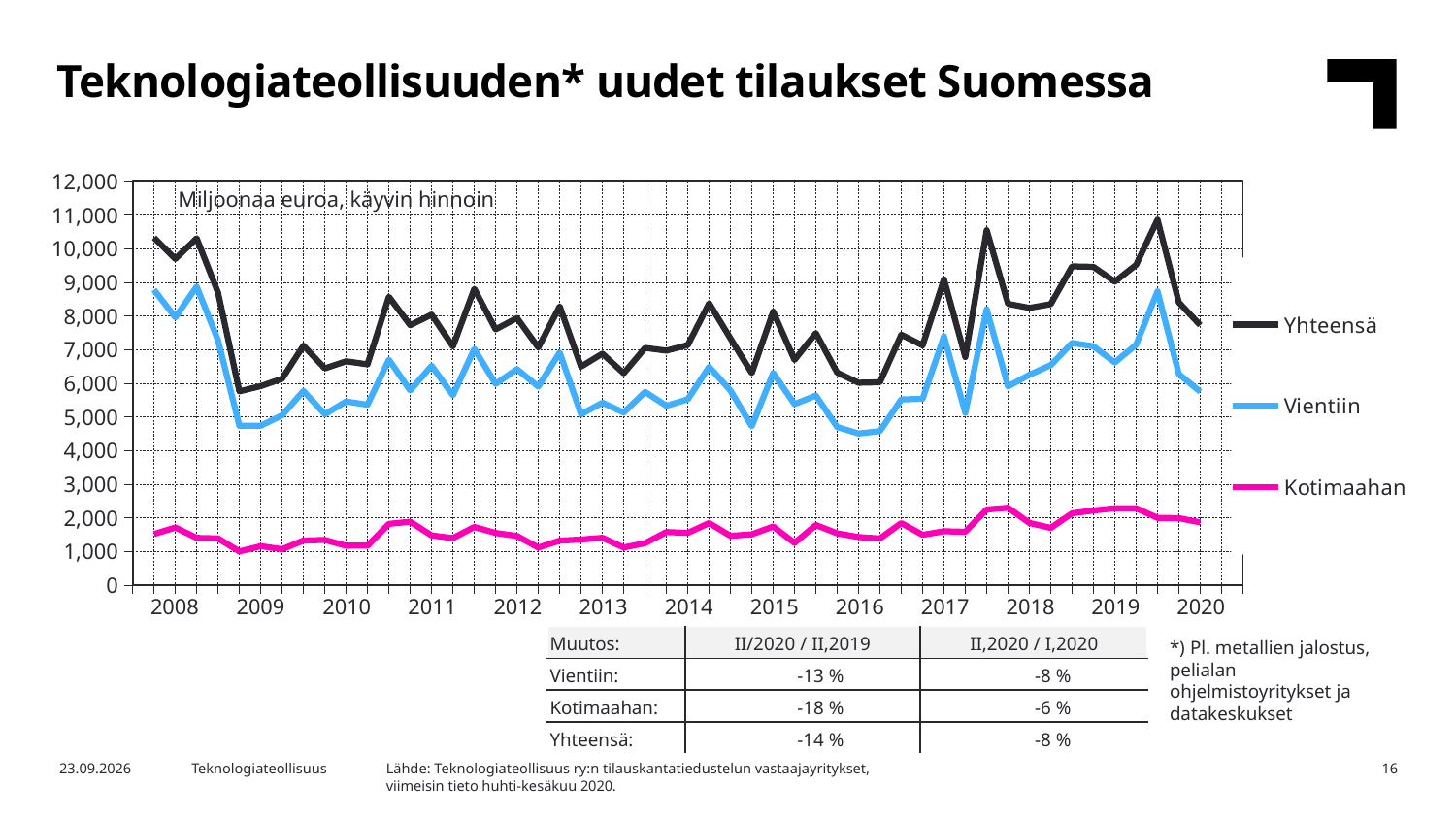
Which series is plotted with the pink line? Kotimaahan Is the first plotted value for Yhteensä in 2008 greater or less than 9,000? greater Do the Yhteensä values rise or fall from the 2019 peak to the end of 2020? fall What kind of chart is shown on the slide? line chart In 2020, which is larger, Vientiin or Kotimaahan? Vientiin What unit note is printed inside the chart area? Miljoonaa euroa, käyvin hinnoin Is the value for Kotimaahan in 2020 greater or less than 3,000? less Is the last plotted value for Vientiin in 2020 greater or less than 7,000? less Which series has the lowest values throughout the chart? Kotimaahan Which series has the highest values throughout the chart? Yhteensä How many series does the chart legend list? 3